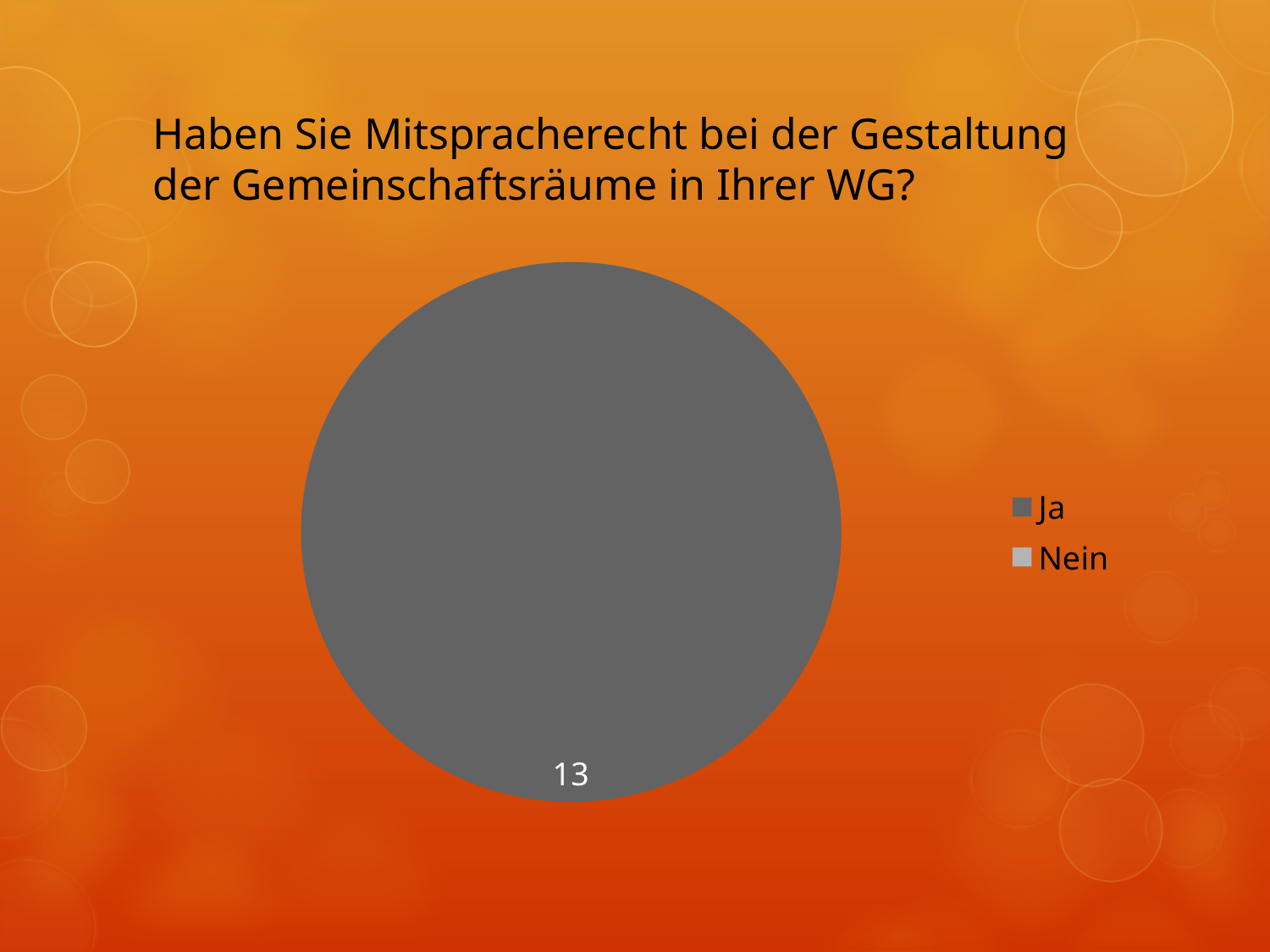
What value is shown for the "Ja" slice of the pie chart? 13 Which is larger in the pie chart, Ja or Nein? Ja What are the two legend entries of the pie chart? Ja, Nein What is the title of the chart on the slide? Haben Sie Mitspracherecht bei der Gestaltung der Gemeinschaftsräume in Ihrer WG? What kind of chart is shown on the slide? pie chart Which category has the smallest share of the pie chart? Nein How many entries does the legend of the pie chart list? 2 Which category has the largest slice in the pie chart? Ja How many categories are listed in the legend of the pie chart? 2